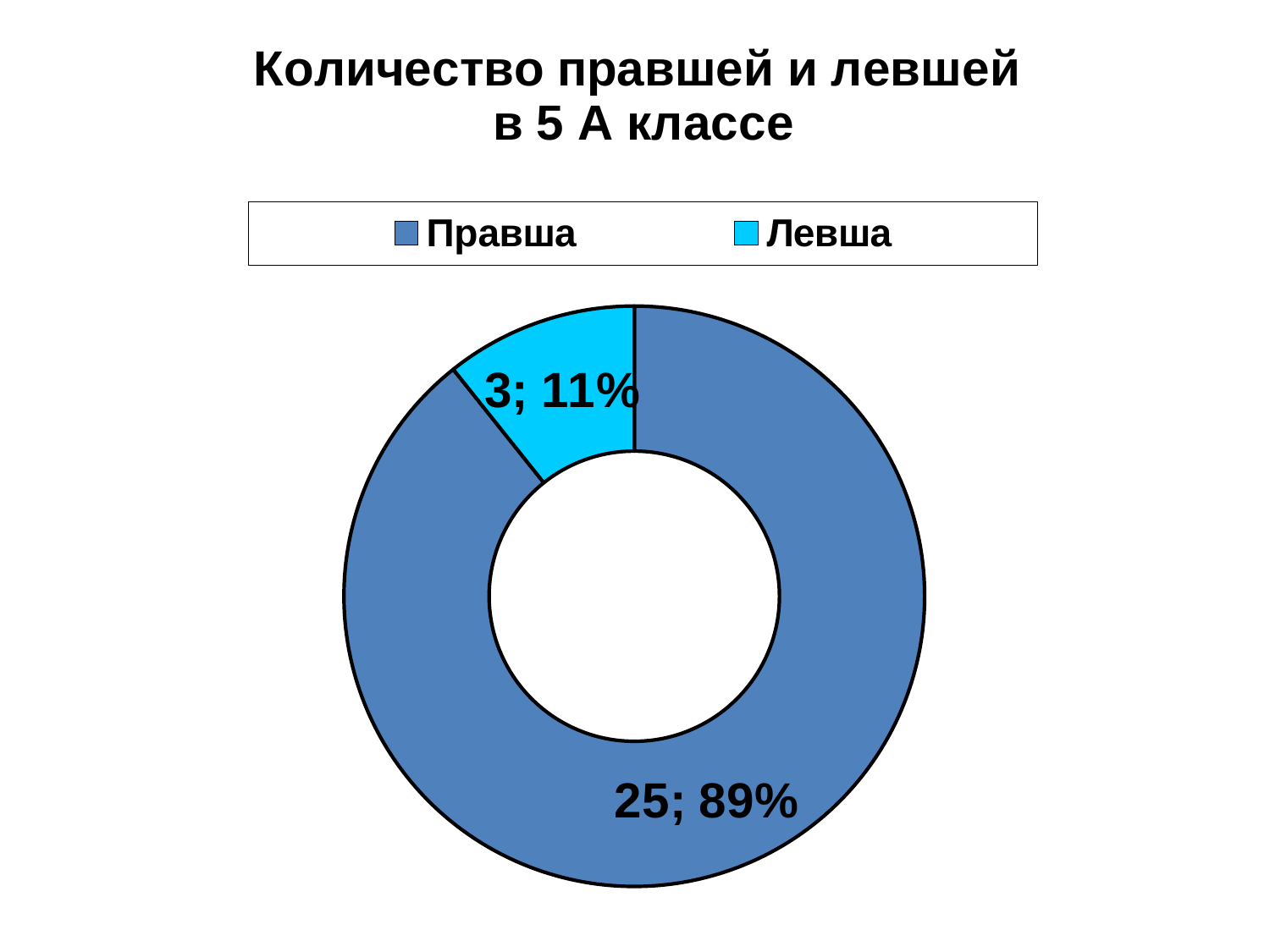
What is the difference between the number of right-handed and left-handed students? 22 What percentage share does the Правша slice have? 89% How many left-handed students (Левша) are shown on the chart? 3 What is the title of the chart? Количество правшей и левшей в 5 А классе Which category has the smallest slice? Левша What type of chart is shown on the slide? Doughnut (pie) chart Which is larger, the value for Правша or the value for Левша? Правша What is the total number of students represented in the chart? 28 How many categories does the chart show? 2 What percentage share does the Левша slice have? 11% Which category has the largest slice? Правша How many right-handed students (Правша) are shown on the chart? 25